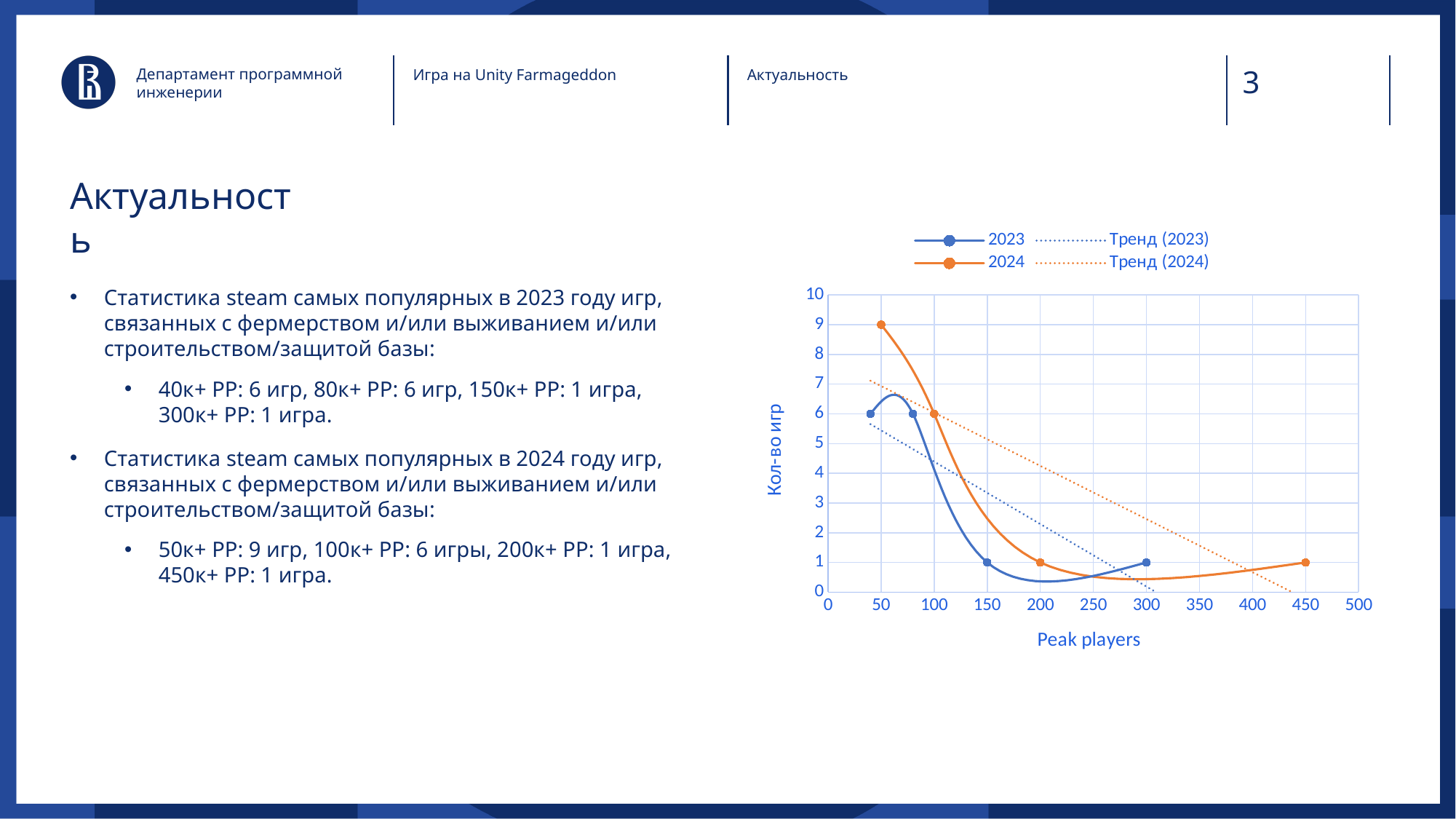
How many entries does the chart legend list? 4 What is the value of the 2023 series at 150 peak players? 1 Which is larger: the 2024 value at 100 peak players or the 2024 value at 200 peak players? 100 peak players What is the value of the 2024 series at 450 peak players? 1 What is the label of the chart's x axis? Peak players Do the values of the 2023 series rise or fall as peak players increase? fall What is the value of the 2024 series at 100 peak players? 6 What is the value of the 2024 series at 50 peak players? 9 What type of chart is shown on the slide? line chart What is the difference between the 2024 value at 50 peak players and the 2024 value at 100 peak players? 3 Which series reaches the highest value on the chart? 2024 What is the label of the chart's y axis? Кол-во игр